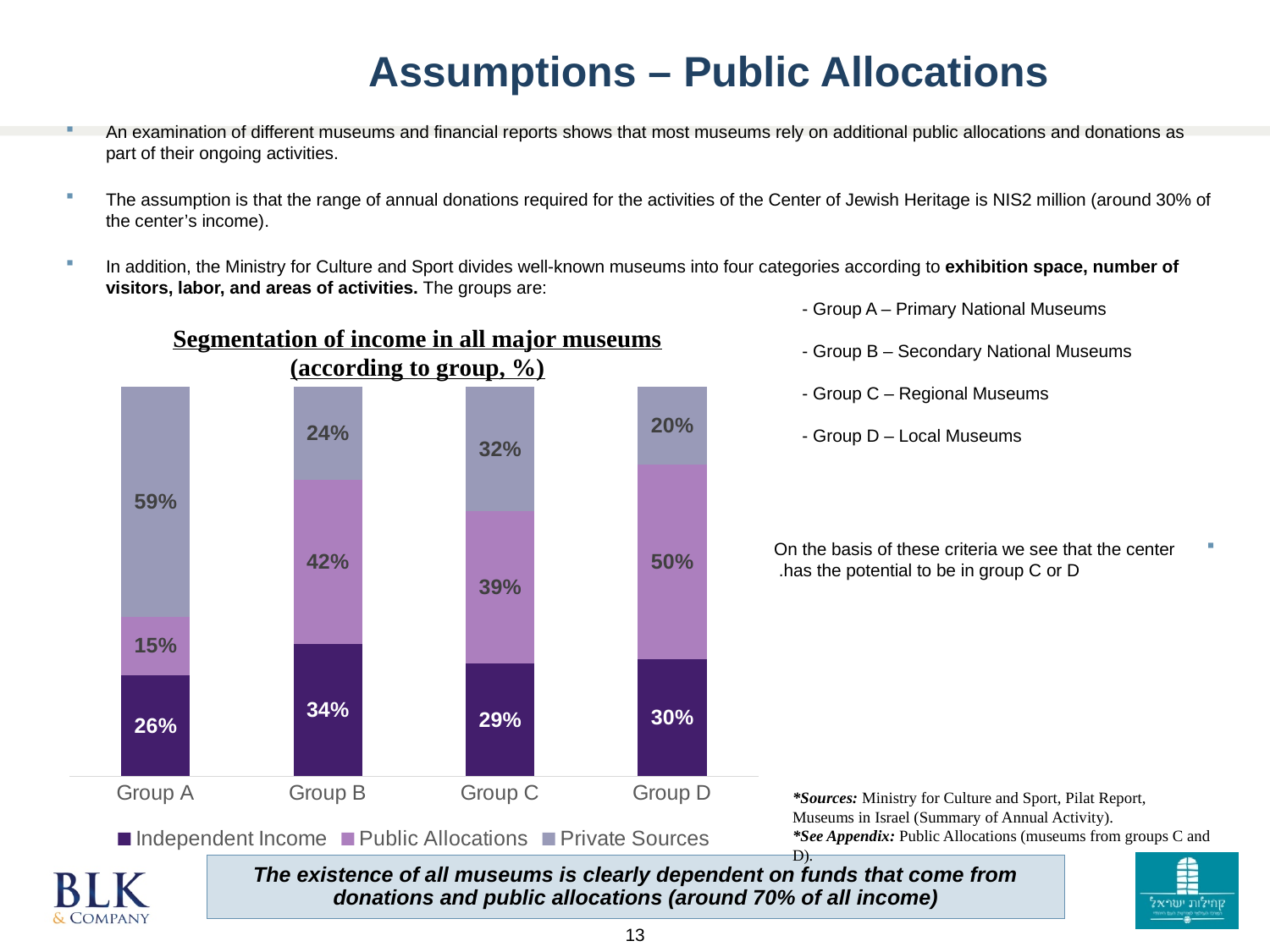
What is the Public Allocations value for Group C? 39% How many series does the chart legend list? 3 What is the Public Allocations value for Group D? 50% Which group has the lowest Public Allocations share? Group A What type of chart is shown on the slide? Stacked bar chart What is the total of the stacked bar for Group C? 100% Which group has the highest Private Sources share? Group A Which is larger: the Independent Income value for Group B or for Group C? Group B What is the Private Sources value for Group B? 24% What is the difference between the Public Allocations values for Group D and Group B? 8% What is the Independent Income value for Group A? 26% How many groups are shown on the x axis of the chart? 4